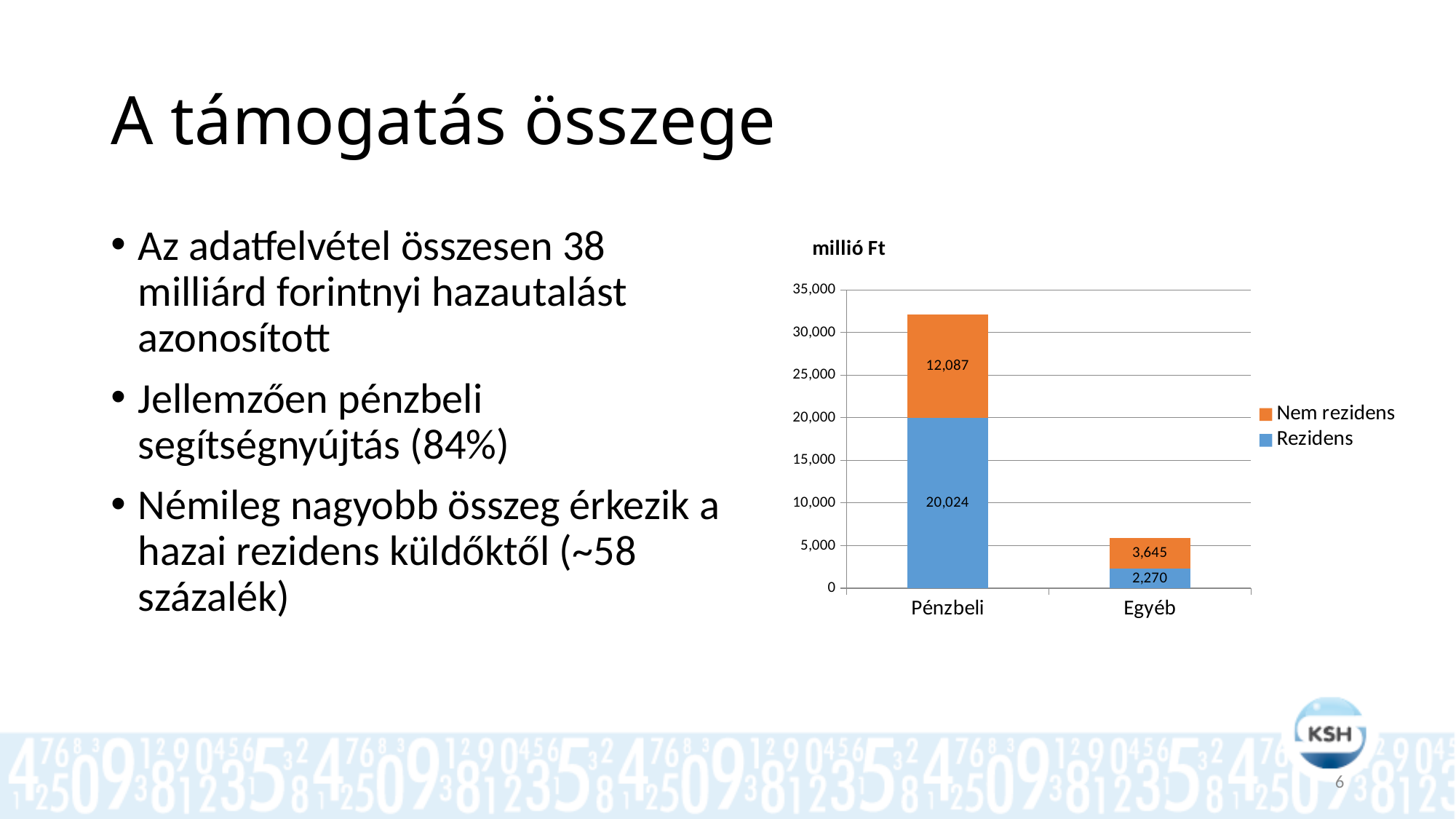
Which category has the highest total bar? Pénzbeli How many series does the legend list? 2 What kind of chart is shown on the slide? Stacked bar chart How many categories are shown on the x axis? 2 What is the difference between the Rezidens and Nem rezidens values for Pénzbeli? 7,937 What is the Rezidens value for Egyéb? 2,270 What is the Nem rezidens value for Egyéb? 3,645 What is the total of the stacked bar for Egyéb? 5,915 What is the total of the stacked bar for Pénzbeli? 32,111 What is the Nem rezidens value for Pénzbeli? 12,087 Which is larger for Egyéb, the Rezidens value or the Nem rezidens value? Nem rezidens What is the Rezidens value for Pénzbeli? 20,024